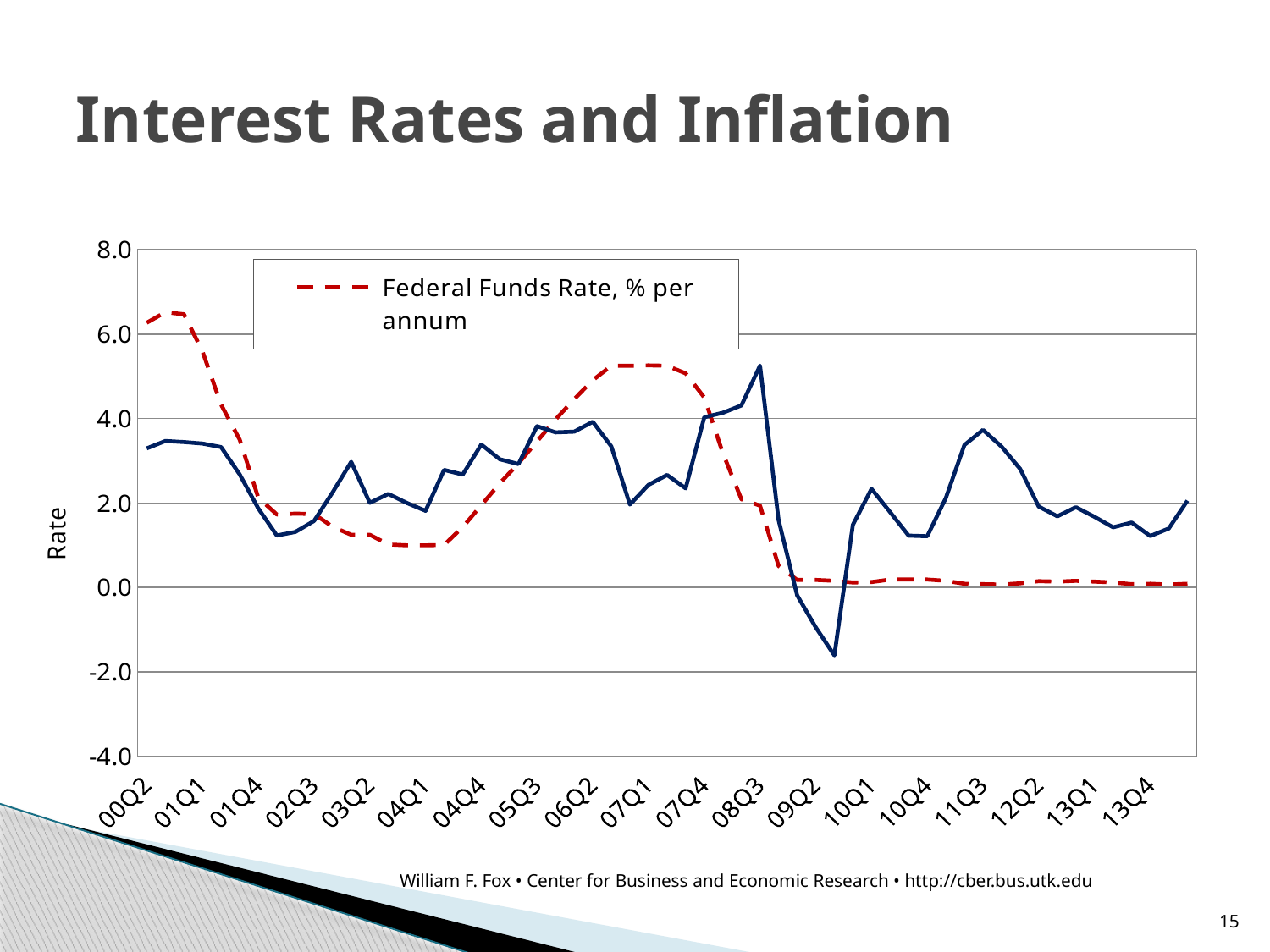
What kind of chart is shown on the slide? line chart Is the Federal Funds Rate at 13Q4 greater or less than 2.0? less Is the Federal Funds Rate at 00Q2 greater or less than 4.0? greater What is the label on the vertical axis of the chart? Rate Is the value of the solid blue line at 09Q2 greater or less than 0.0? less How many series does the legend list? 1 Does the Federal Funds Rate rise or fall between 00Q2 and 01Q4? fall Does the Federal Funds Rate rise or fall between 04Q1 and 07Q1? rise What is the title of the chart on the slide? Interest Rates and Inflation